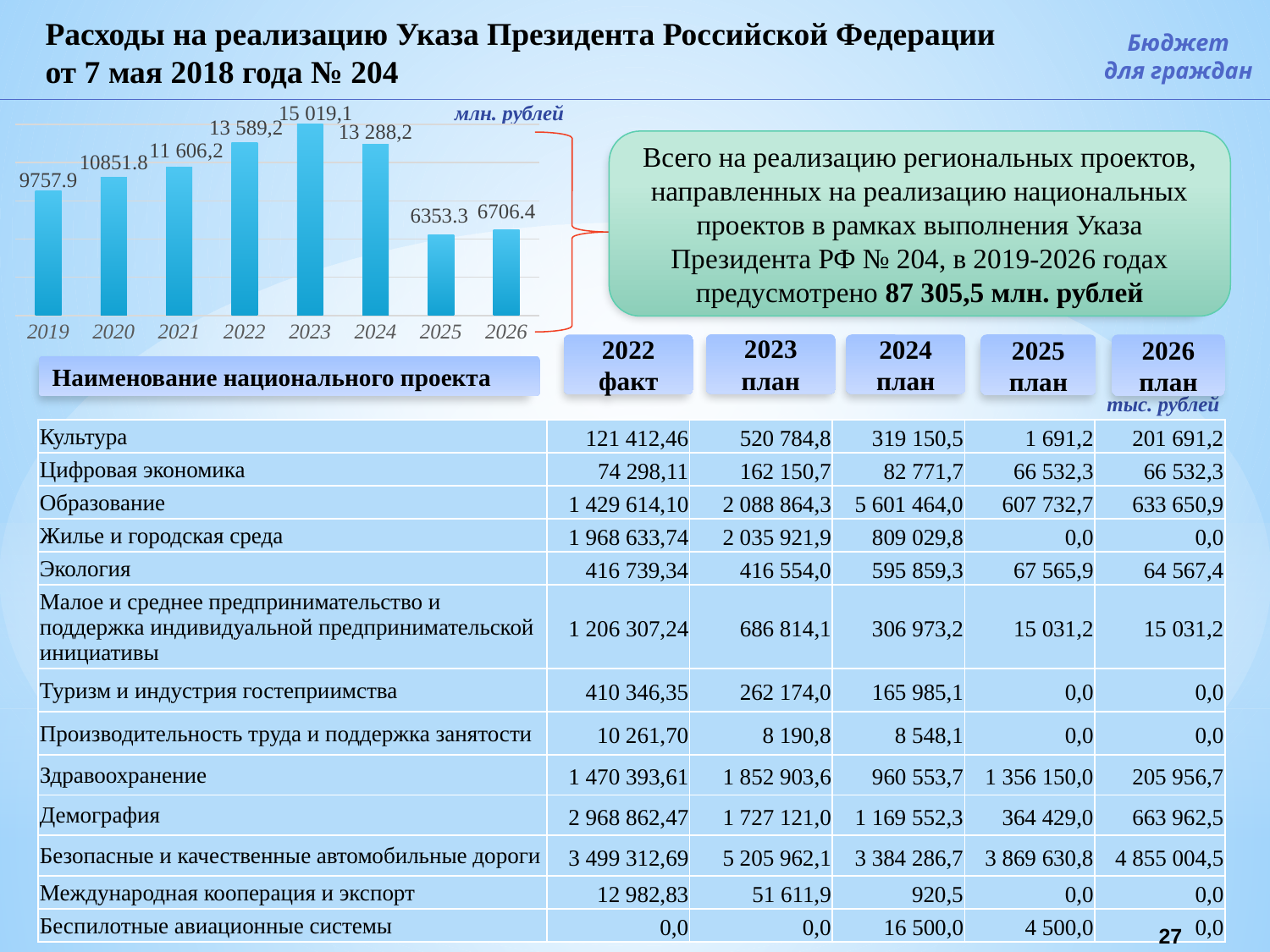
What type of chart is shown at the top left of the slide? bar chart What is the value for 2022 in the bar chart? 13 589,2 In the bar chart, what is the difference between the values for 2023 and 2024? 1 730,9 In the bar chart, what is the difference between the values for 2026 and 2025? 353.1 Which year has the highest value in the bar chart? 2023 What is the value for 2025 in the bar chart? 6353.3 What is the value for 2019 in the bar chart? 9757.9 Do the values in the bar chart rise or fall from 2019 to 2023? rise Which year has the lowest value in the bar chart? 2025 How many years (bars) does the bar chart show? 8 In the bar chart, which year has the larger value, 2021 or 2022? 2022 What is the value for 2023 in the bar chart? 15 019,1